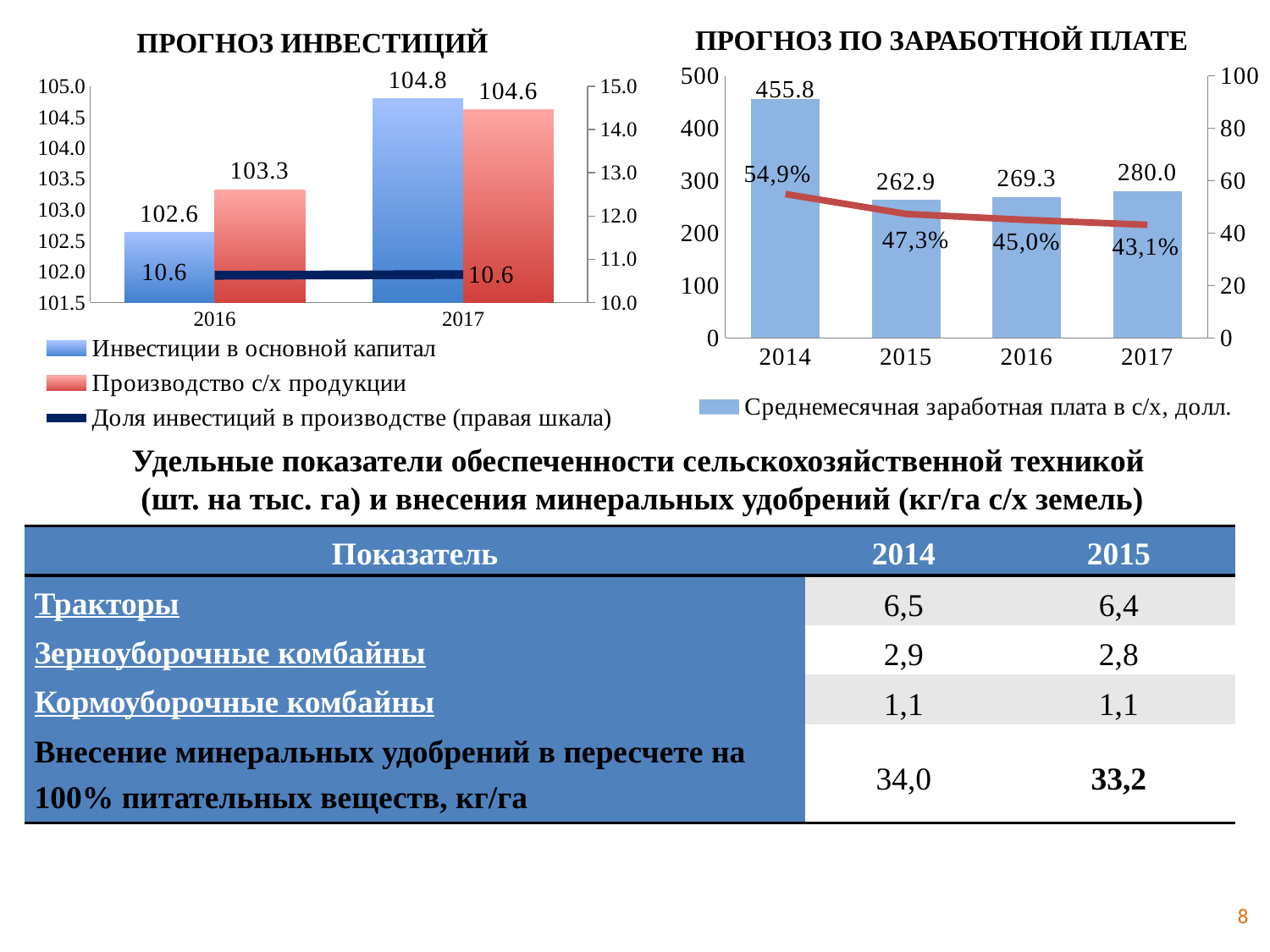
In the chart titled "ПРОГНОЗ ИНВЕСТИЦИЙ", by how much does "Инвестиции в основной капитал" increase from 2016 to 2017? 2.2 In the chart titled "ПРОГНОЗ ИНВЕСТИЦИЙ", what is the value of "Производство с/х продукции" for 2017? 104.6 In the chart titled "ПРОГНОЗ ПО ЗАРАБОТНОЙ ПЛАТЕ", which year has the lowest average monthly wage? 2015 In the chart titled "ПРОГНОЗ ПО ЗАРАБОТНОЙ ПЛАТЕ", what is the difference between the wage in 2014 and the wage in 2017? 175.8 In the chart titled "ПРОГНОЗ ПО ЗАРАБОТНОЙ ПЛАТЕ", which year has the highest average monthly wage? 2014 In the chart titled "ПРОГНОЗ ИНВЕСТИЦИЙ", how many series does the legend list? 3 In the chart titled "ПРОГНОЗ ПО ЗАРАБОТНОЙ ПЛАТЕ", what is the average monthly wage for 2015? 262.9 In the chart titled "ПРОГНОЗ ПО ЗАРАБОТНОЙ ПЛАТЕ", how many years are shown on the x axis? 4 In the chart titled "ПРОГНОЗ ИНВЕСТИЦИЙ", what is the value of "Инвестиции в основной капитал" for 2016? 102.6 In the chart titled "ПРОГНОЗ ПО ЗАРАБОТНОЙ ПЛАТЕ", what percentage is labelled on the line for 2017? 43,1% In the chart titled "ПРОГНОЗ ИНВЕСТИЦИЙ", what is the value of "Доля инвестиций в производстве" for 2016? 10.6 In the chart titled "ПРОГНОЗ ИНВЕСТИЦИЙ", which series is shown in red? Производство с/х продукции